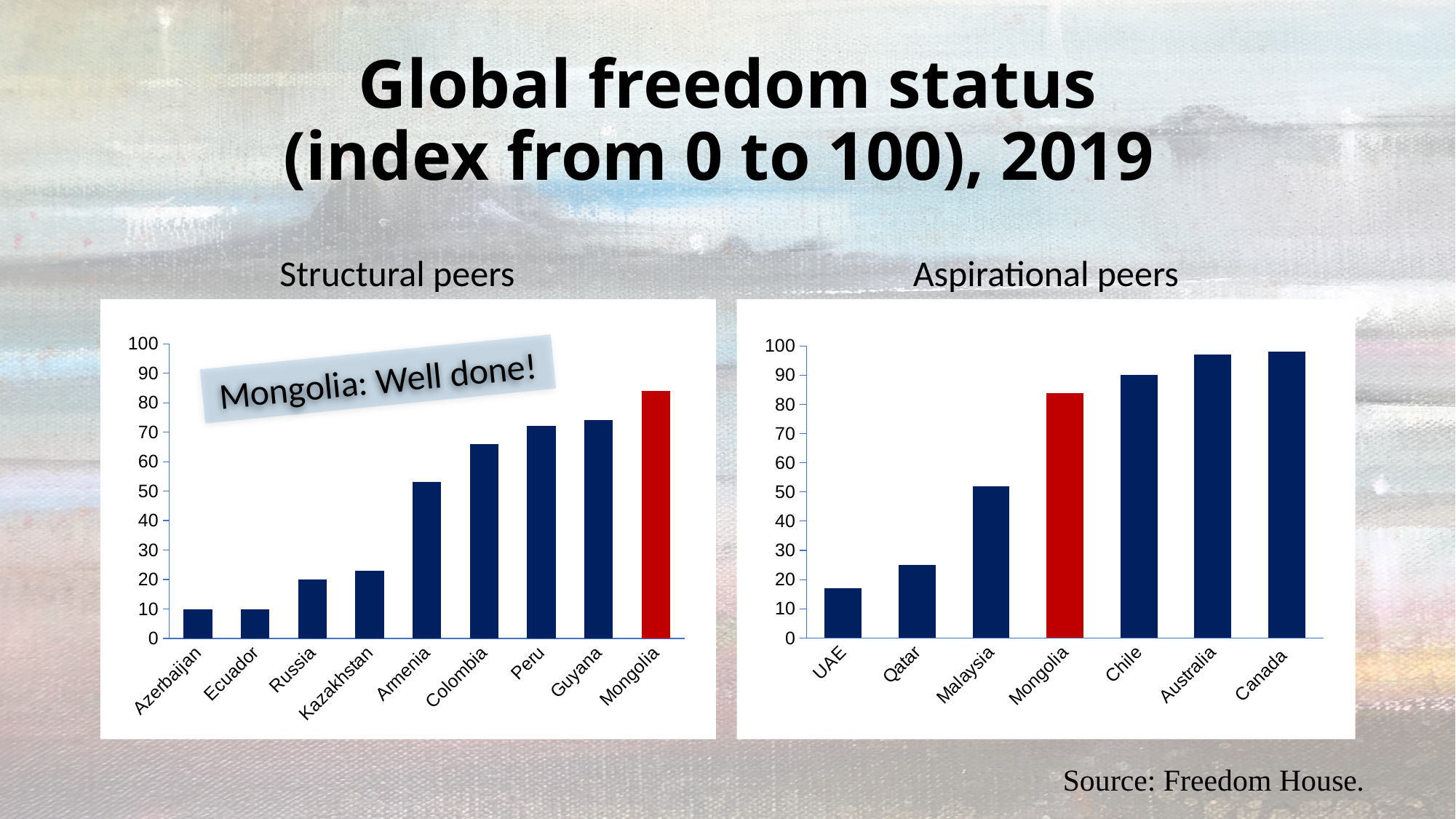
In the Aspirational peers chart, is the value for Malaysia greater or less than 60? less How many countries are shown in the Aspirational peers chart? 7 In the Aspirational peers chart, which has the larger value, Mongolia or Malaysia? Mongolia Do the values in the Aspirational peers chart rise or fall from left to right? rise In the Aspirational peers chart, is the value for Qatar greater or less than 30? less In the Structural peers chart, which has the larger value, Armenia or Kazakhstan? Armenia How many countries are shown in the Structural peers chart? 9 What kind of chart is the Structural peers chart? bar chart In the Structural peers chart, which country's bar is coloured red? Mongolia In the Structural peers chart, is the value for Mongolia greater or less than 80? greater In the Aspirational peers chart, which country has the lowest value? UAE In the Structural peers chart, which country has the highest value? Mongolia